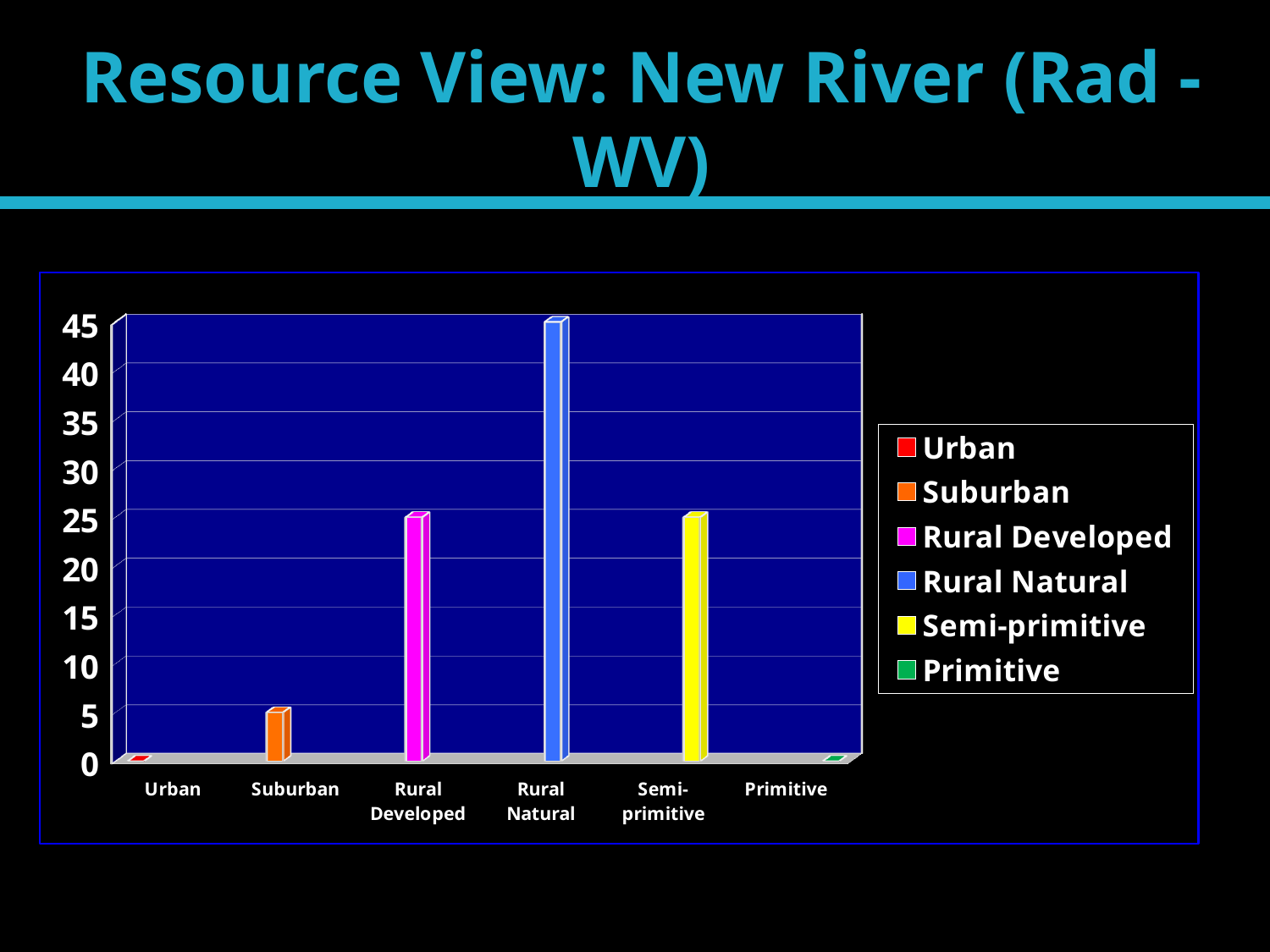
What colour is the bar for Semi-primitive? yellow Is the value for Semi-primitive greater or less than 30? less Is the value for Suburban greater or less than 10? less Which category has the highest bar? Rural Natural What kind of chart is shown on the slide? bar chart Is the value for Urban greater or less than 5? less How many categories are shown on the x axis? 6 How many entries does the legend list? 6 What is the title of the slide containing the chart? Resource View: New River (Rad - WV) Which is larger, the value for Suburban or the value for Rural Developed? Rural Developed